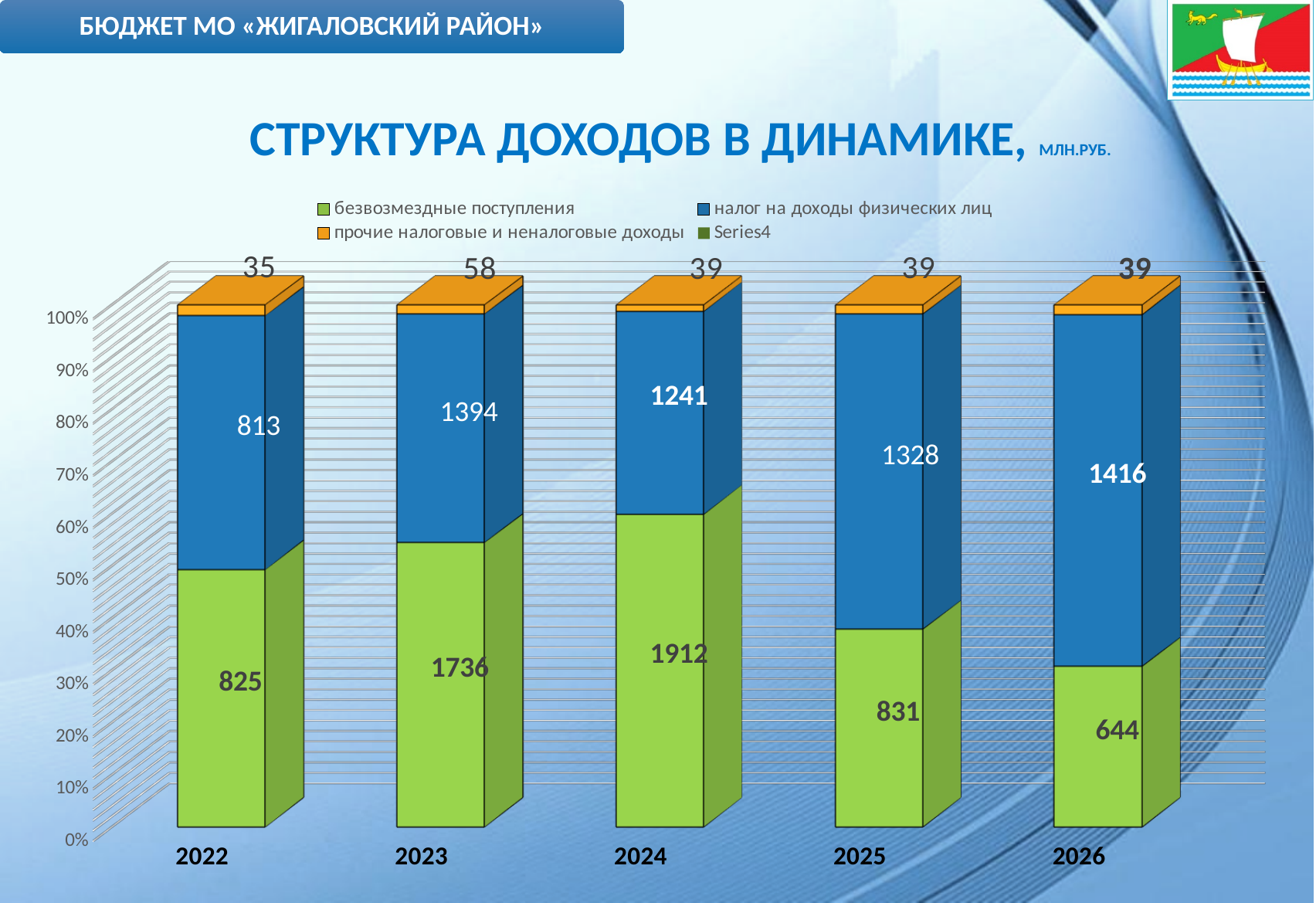
Which is larger in 2025: безвозмездные поступления or налог на доходы физических лиц? налог на доходы физических лиц What is the value of налог на доходы физических лиц for 2026? 1416 What unit is given in the chart title? млн.руб. What is the value of прочие налоговые и неналоговые доходы for 2023? 58 In which year is безвозмездные поступления highest? 2024 What kind of chart is shown on the slide? stacked bar chart How many years are shown on the x axis? 5 What is the value of безвозмездные поступления for 2024? 1912 What is the total of the stacked bar for 2022? 1673 In which year is безвозмездные поступления lowest? 2026 What is the difference between налог на доходы физических лиц in 2026 and in 2022? 603 How many series does the legend list? 4